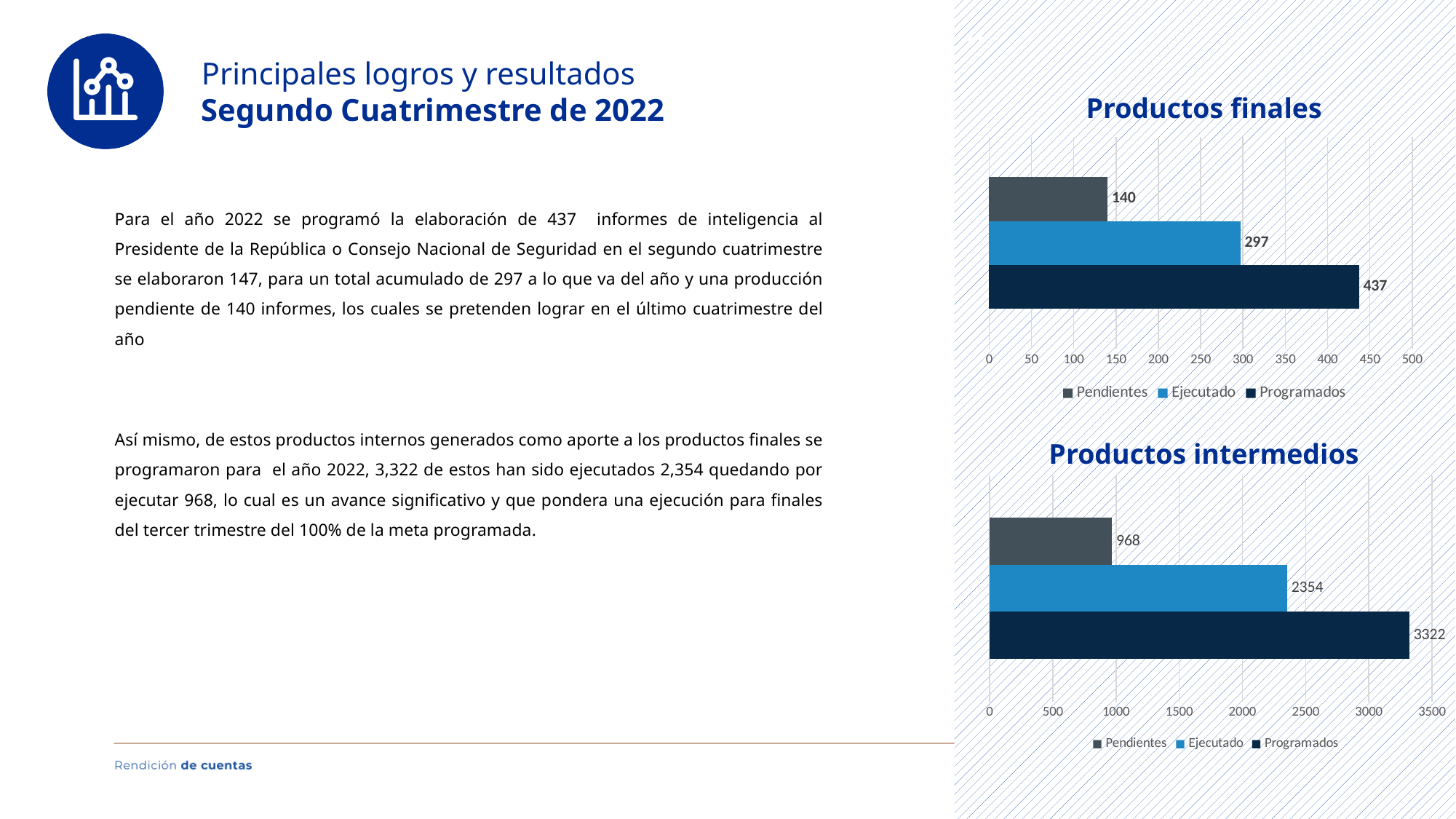
In the 'Productos intermedios' chart, what is the value for Ejecutado? 2354 In the 'Productos intermedios' chart, is the value for Ejecutado greater or less than 2000? greater In the 'Productos finales' chart, what is the value for Programados? 437 What kind of chart is the 'Productos intermedios' chart? Bar chart In the 'Productos intermedios' chart, what is the difference between Programados and Ejecutado? 968 In the 'Productos finales' chart, what is the difference between Programados and Ejecutado? 140 In the 'Productos finales' chart, which series has the lowest value? Pendientes In the 'Productos finales' chart, how many series does the legend list? 3 In the 'Productos finales' chart, what is the value for Ejecutado? 297 In the 'Productos intermedios' chart, which series has the highest value? Programados In the 'Productos intermedios' chart, what is the value for Pendientes? 968 In the 'Productos finales' chart, which is larger, Pendientes or Ejecutado? Ejecutado